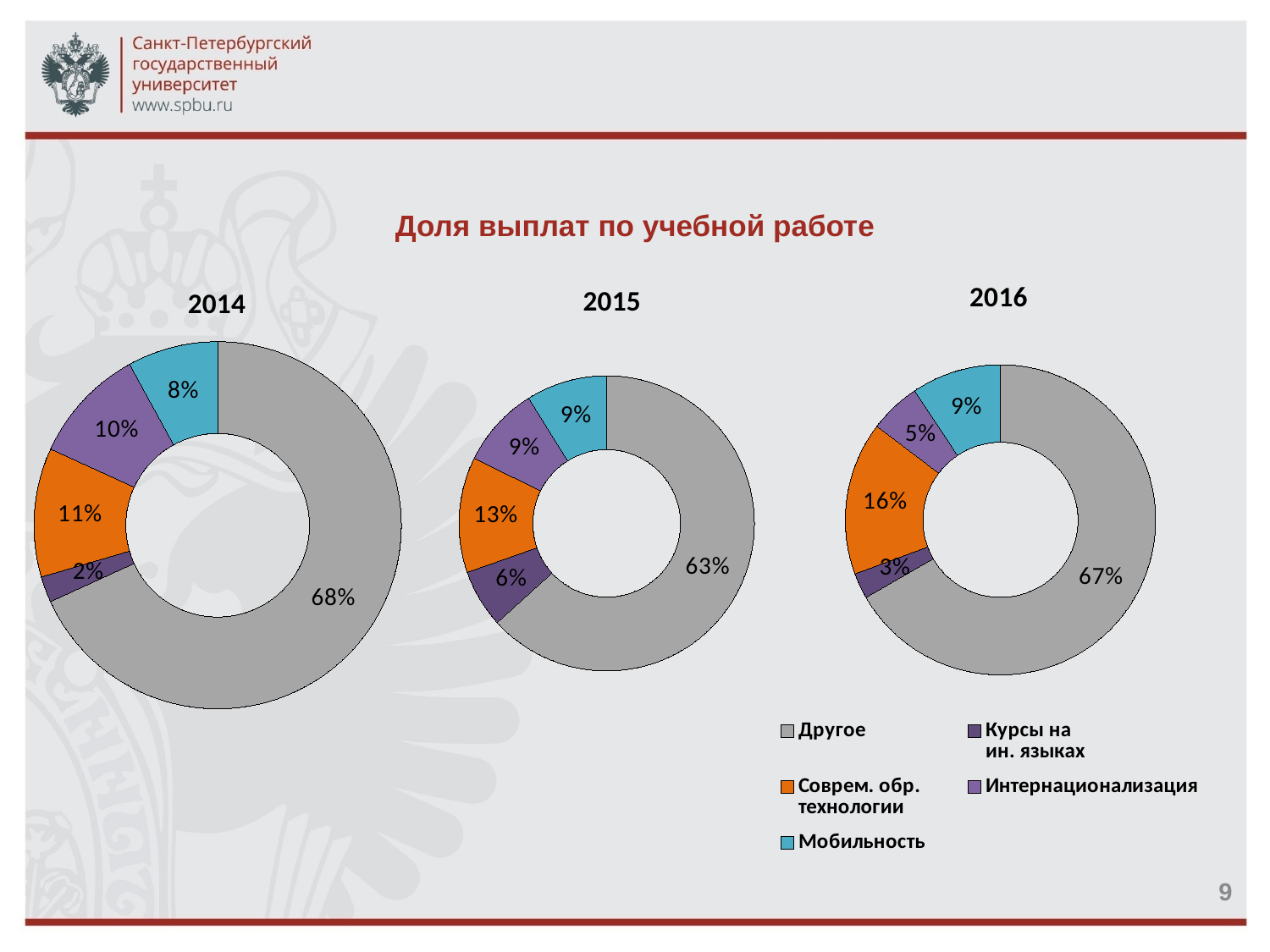
What kind of chart is used for 2014, 2015 and 2016? Doughnut (pie) chart In the 2016 chart, what share is labelled for Курсы на ин. языках? 3% In the 2015 chart, what share is labelled for Соврем. обр. технологии? 13% In the 2014 chart, what share is labelled for Другое? 68% Which colour represents Мобильность in the legend? Light blue How many categories does the legend list for the charts? 5 In the 2016 chart, what share is labelled for Интернационализация? 5% In the 2014 chart, which category has the smallest share? Курсы на ин. языках In the 2015 chart, what is the difference between the shares of Другое and Соврем. обр. технологии? 50% What is the title shown above the three charts? Доля выплат по учебной работе In the 2014 chart, which is larger: the share of Соврем. обр. технологии or the share of Мобильность? Соврем. обр. технологии In the 2016 chart, which category has the largest share? Другое